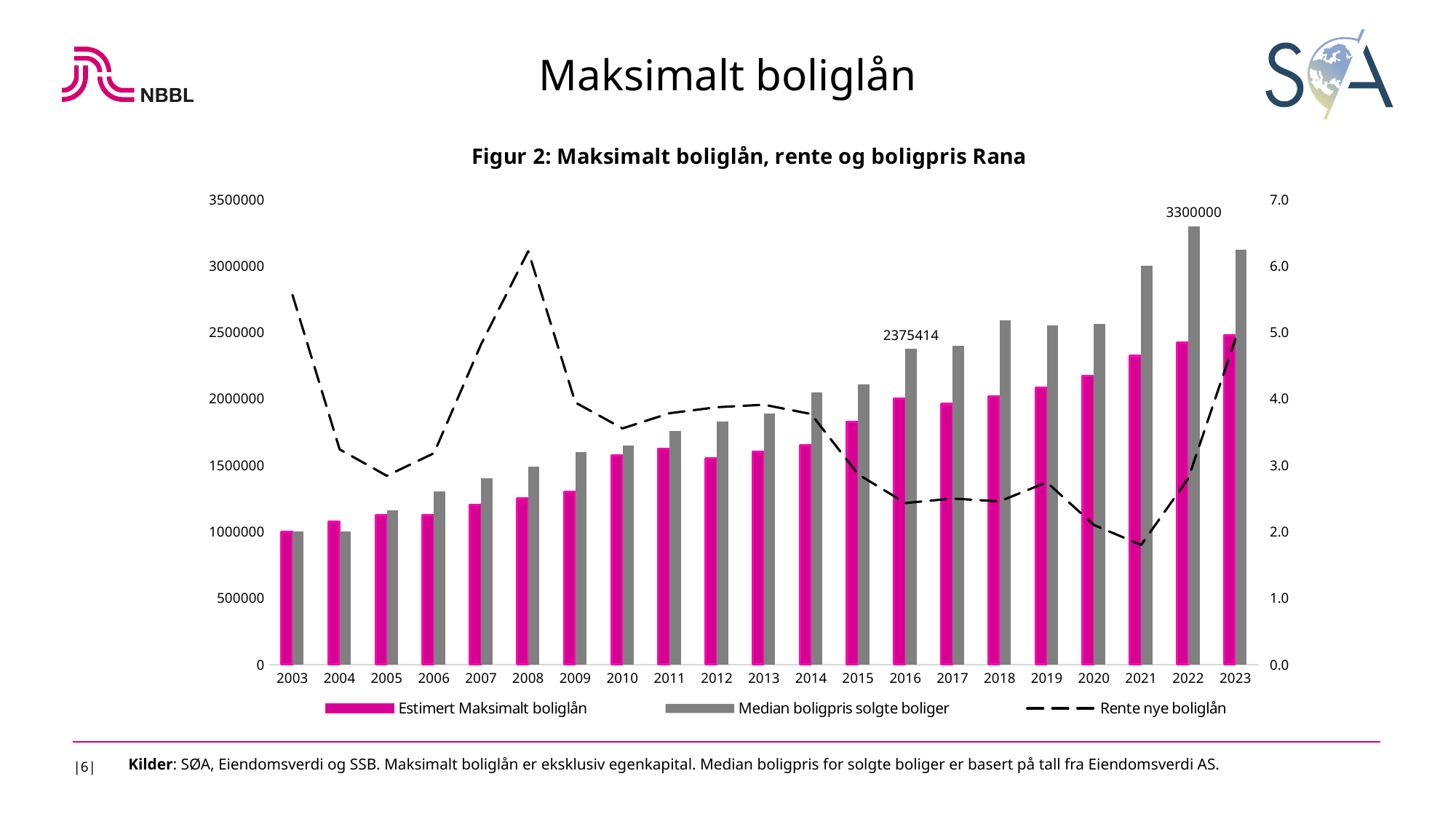
Is the value of Rente nye boliglån in 2021 greater or less than 2.0? less Does Estimert Maksimalt boliglån rise or fall from 2003 to 2023? rise Is the value of Estimert Maksimalt boliglån in 2023 greater or less than 2000000? greater In which year is Estimert Maksimalt boliglån lowest? 2003 How many years are shown on the x axis? 21 How many series does the legend list? 3 Which is larger, Median boligpris solgte boliger in 2022 or in 2023? 2022 What is the value of Median boligpris solgte boliger in 2016? 2375414 What kind of chart is used for Estimert Maksimalt boliglån and Median boligpris solgte boliger? bar chart What is the value of Median boligpris solgte boliger in 2022? 3300000 What is the difference between the Median boligpris solgte boliger in 2022 and in 2016? 924586 In which year is Median boligpris solgte boliger highest? 2022